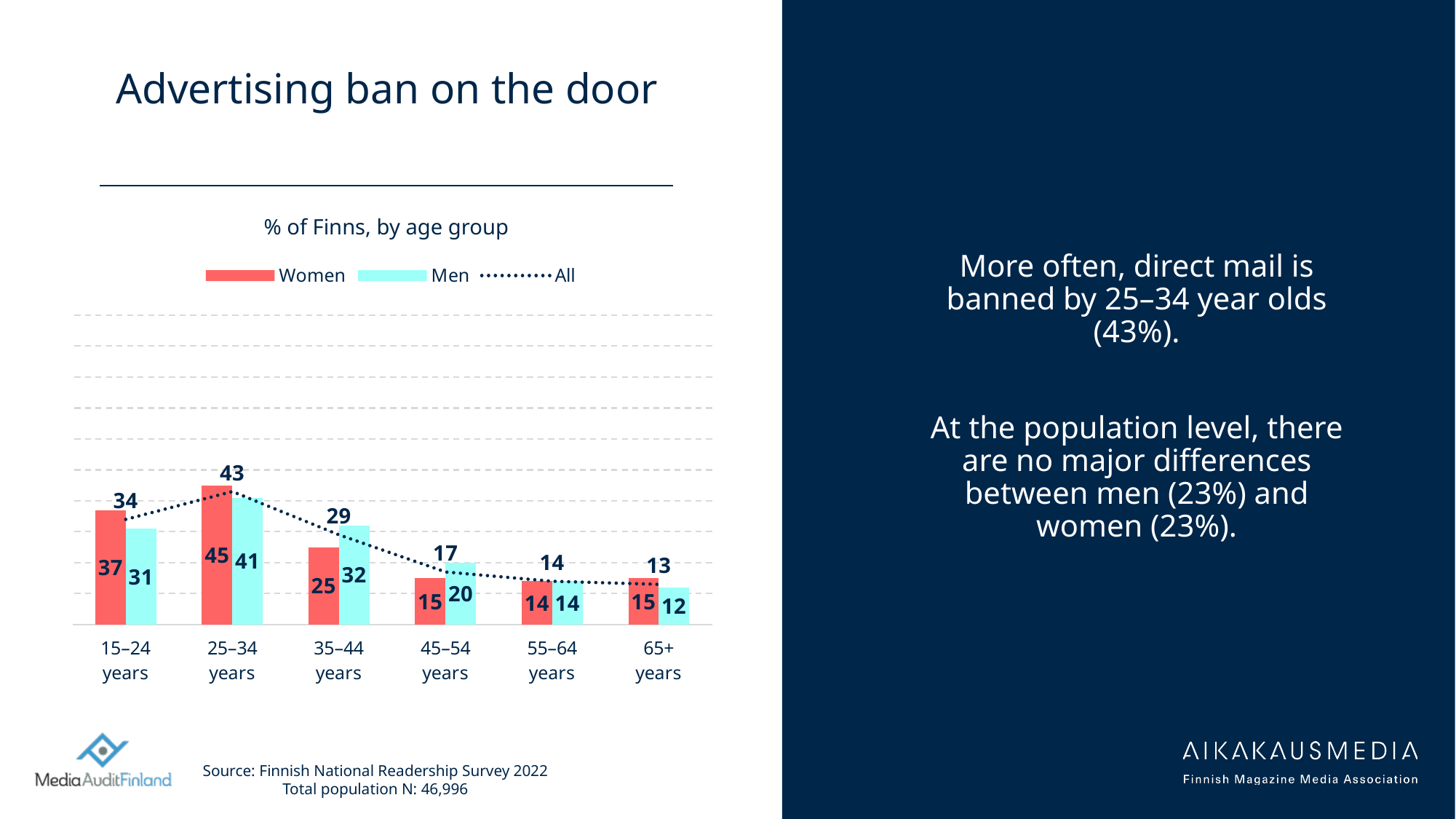
How many age groups are shown on the x axis? 6 What is the difference between the Women and Men values in the 15–24 years age group? 6 In the 35–44 years age group, which is larger, the value for Women or for Men? Men Which age group has the lowest value for Men? 65+ years What kind of chart is used to show the Women and Men values? Bar chart What is the value for Men in the 35–44 years age group? 32 Which series is shown as a dotted line? All What is the value of the All series for the 45–54 years age group? 17 Which age group has the highest value for the All series? 25–34 years How many series does the legend list? 3 What is the value for Women in the 25–34 years age group? 45 Does the All series rise or fall from the 25–34 years group to the 65+ years group? Fall